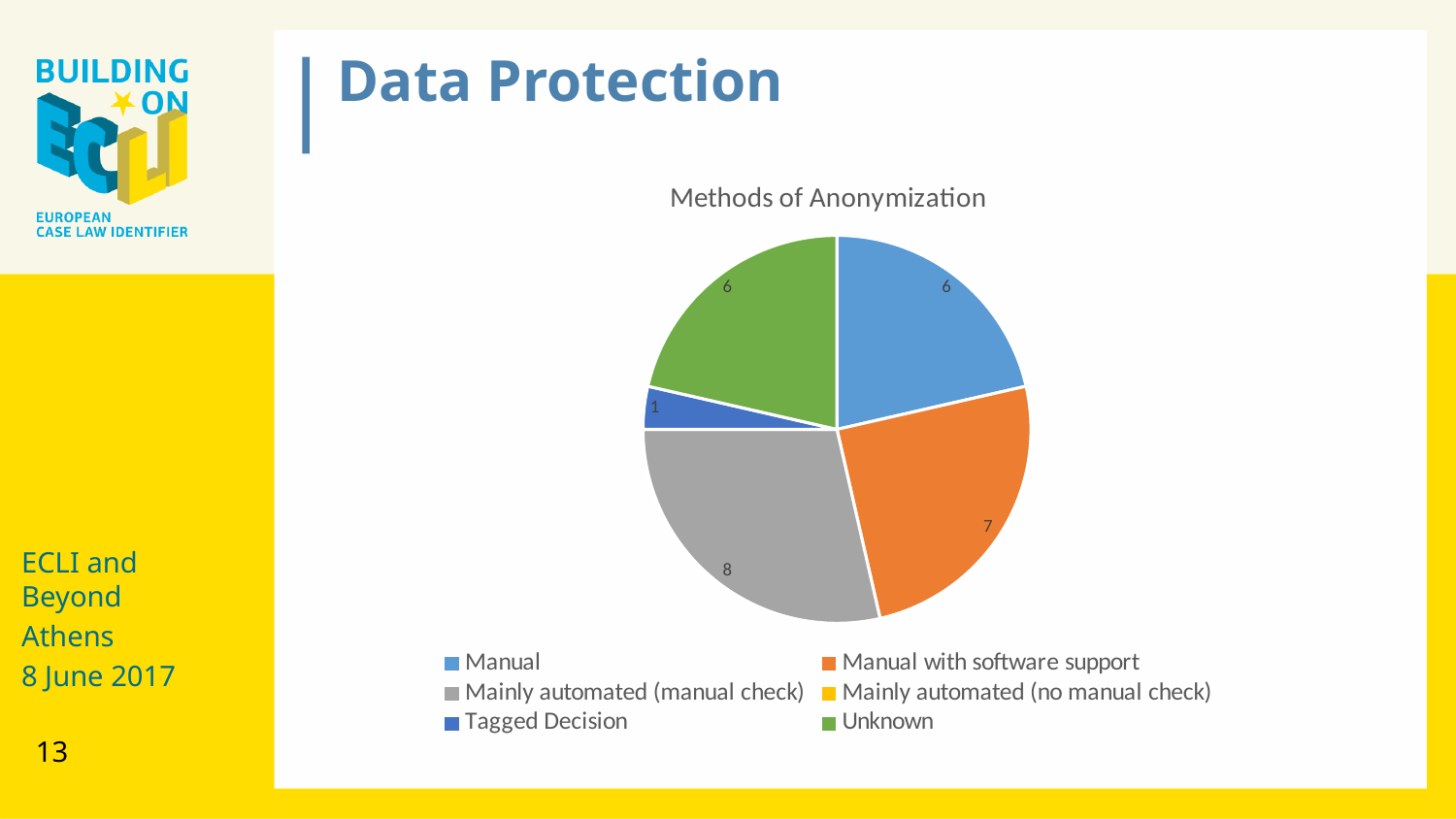
Which method of anonymization has the largest slice? Mainly automated (manual check) What is the title of the chart? Methods of Anonymization What is the value for Manual with software support? 7 What is the value for Unknown? 6 Which labelled slice has the smallest value? Tagged Decision What is the value for Mainly automated (manual check)? 8 What is the value for Tagged Decision? 1 How many categories does the legend list? 6 What is the difference between the values for Mainly automated (manual check) and Tagged Decision? 7 What is the value for Manual in the Methods of Anonymization chart? 6 What type of chart is shown on the slide? Pie chart Which is larger, Manual with software support or Manual? Manual with software support